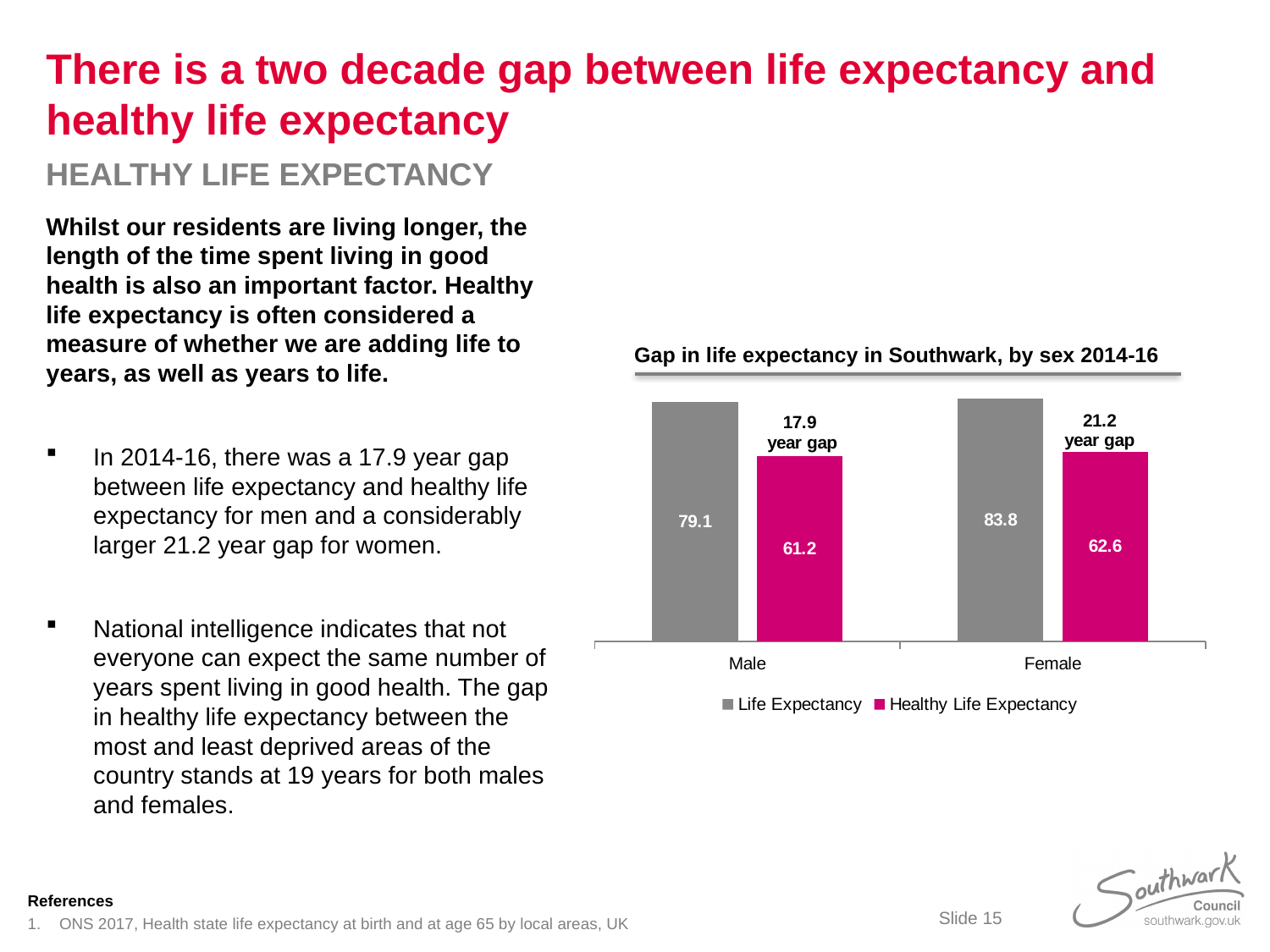
What is the Life Expectancy value for Male? 79.1 How many series does the legend list? 2 What is the Healthy Life Expectancy value for Male? 61.2 What is the Healthy Life Expectancy value for Female? 62.6 What kind of chart is shown? Bar chart What is the title of the chart? Gap in life expectancy in Southwark, by sex 2014-16 What is the difference in Life Expectancy between Female and Male? 4.7 What is the Life Expectancy value for Female? 83.8 Which category has the higher Life Expectancy, Male or Female? Female How many categories are shown on the x axis? 2 What is the difference between Life Expectancy and Healthy Life Expectancy for Female? 21.2 What is the difference between Life Expectancy and Healthy Life Expectancy for Male? 17.9